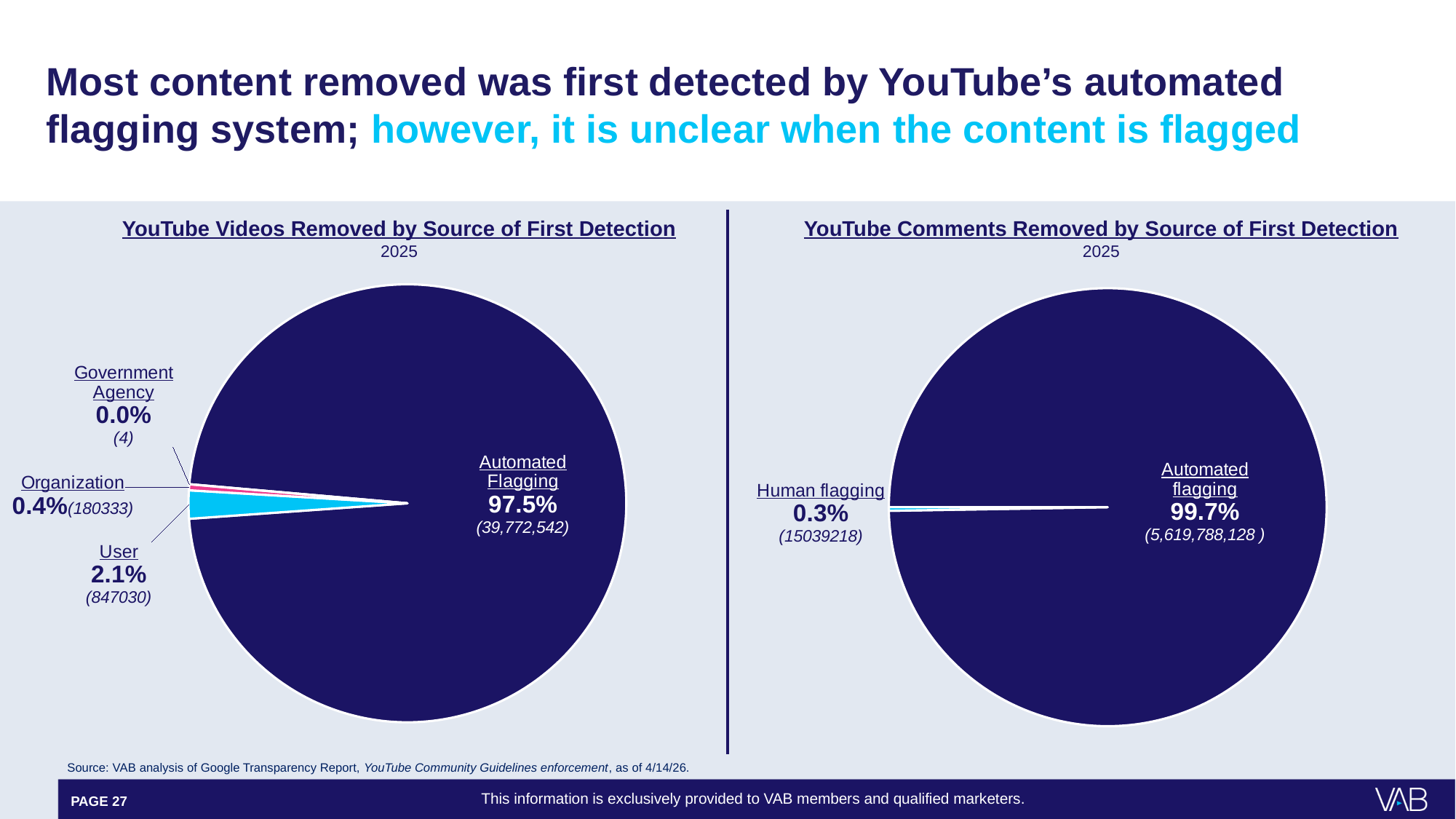
In the 'YouTube Videos Removed by Source of First Detection' chart, what share of removed videos was first detected by Automated Flagging? 97.5% In the 'YouTube Videos Removed by Source of First Detection' chart, what is the difference in percentage points between the User share and the Organization share? 1.7 In the 'YouTube Videos Removed by Source of First Detection' chart, what percentage of removed videos was first detected by a User? 2.1% In the 'YouTube Videos Removed by Source of First Detection' chart, how many videos were first detected by a Government Agency? 4 In the 'YouTube Comments Removed by Source of First Detection' chart, what share of removed comments was first detected by Automated flagging? 99.7% In the 'YouTube Videos Removed by Source of First Detection' chart, which source has the smallest share? Government Agency In the 'YouTube Videos Removed by Source of First Detection' chart, how many source categories are shown? 4 What year do both charts on the slide cover? 2025 What type of chart is used on the left side of the slide for YouTube Videos Removed by Source of First Detection? Pie chart In the 'YouTube Comments Removed by Source of First Detection' chart, how many comments were first detected by Human flagging? 15039218 In the 'YouTube Videos Removed by Source of First Detection' chart, how many videos were first detected by an Organization? 180333 In the 'YouTube Comments Removed by Source of First Detection' chart, which source has the larger share, Automated flagging or Human flagging? Automated flagging